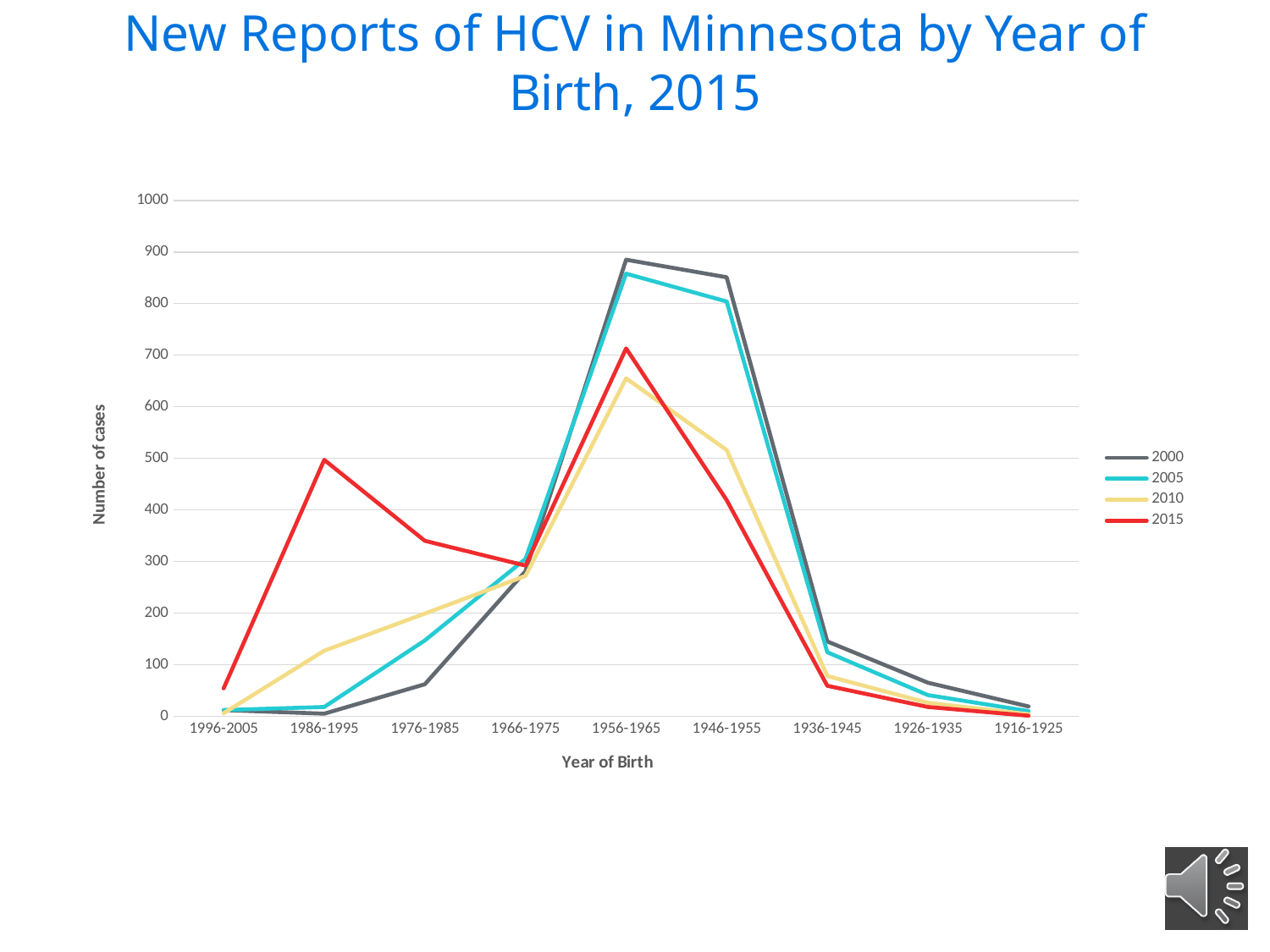
For the 2015 series, which year-of-birth category has the lowest number of cases? 1916-1925 How many series does the legend list? 4 How many year-of-birth categories are shown on the x axis? 9 For the 2015 series, which year-of-birth category has the highest number of cases? 1956-1965 For the 1946-1955 category, which series has more cases, 2000 or 2010? 2000 Is the 2000 value for 1956-1965 greater or less than 800? greater What kind of chart is shown on the slide? line chart Is the 2015 value for 1986-1995 greater or less than 400? greater What is the label of the y axis? Number of cases For the 1986-1995 category, which series has more cases, 2015 or 2000? 2015 Is the 2010 value for 1956-1965 greater or less than 700? less For the 2000 series, which year-of-birth category has the highest number of cases? 1956-1965